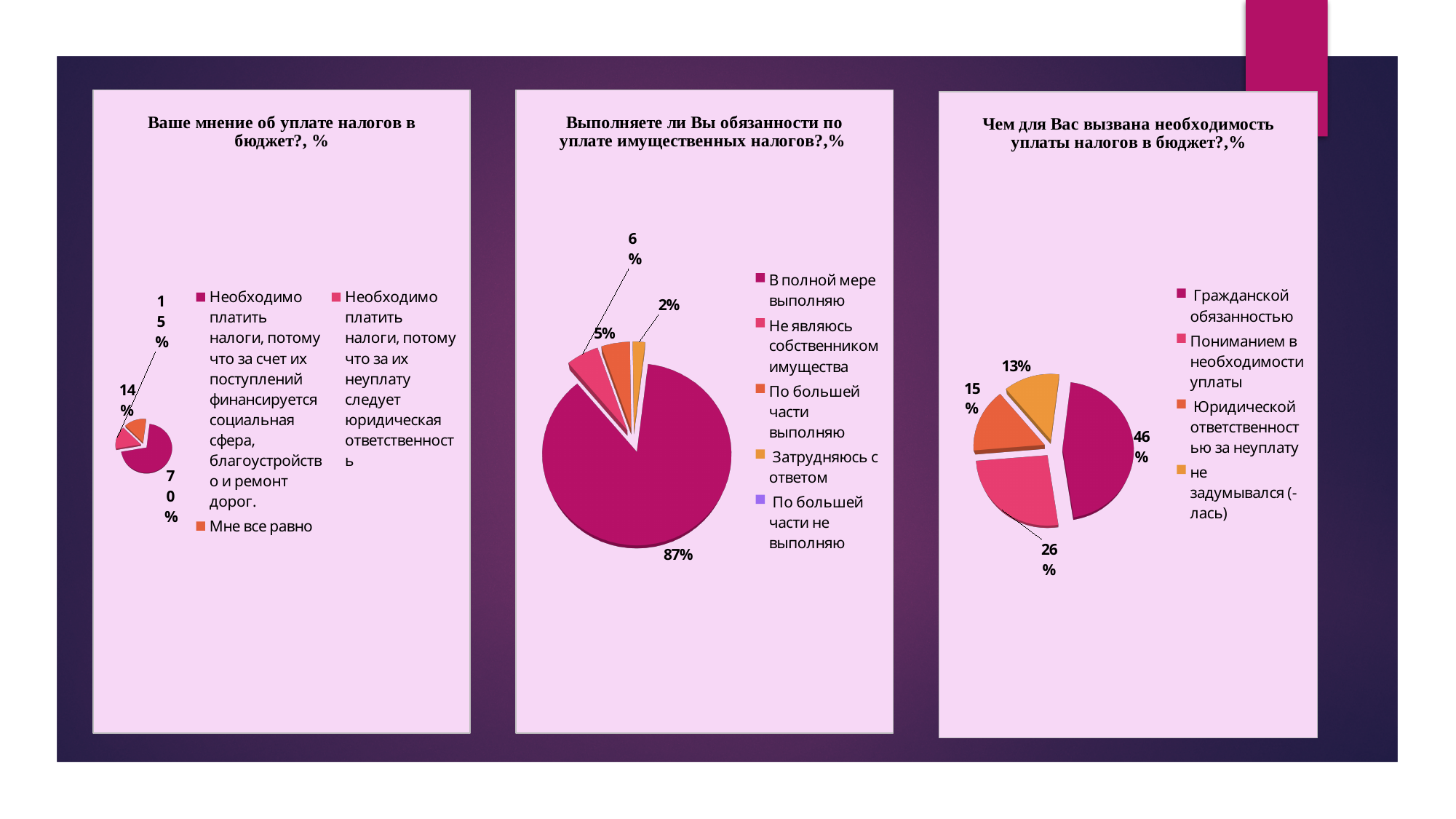
On the chart titled "Ваше мнение об уплате налогов в бюджет?, %", which category has the largest slice? Необходимо платить налоги, потому что за счет их поступлений финансируется социальная сфера, благоустройство и ремонт дорог. On the chart titled "Выполняете ли Вы обязанности по уплате имущественных налогов?,%", how many entries does the legend list? 5 On the chart titled "Чем для Вас вызвана необходимость уплаты налогов в бюджет?,%", what share is labelled for "Пониманием в необходимости уплаты"? 26% On the chart titled "Ваше мнение об уплате налогов в бюджет?, %", what share is labelled for "Мне все равно"? 14% On the chart titled "Выполняете ли Вы обязанности по уплате имущественных налогов?,%", what share is labelled for "Затрудняюсь с ответом"? 2% What type of chart is the chart titled "Ваше мнение об уплате налогов в бюджет?, %"? Pie chart On the chart titled "Чем для Вас вызвана необходимость уплаты налогов в бюджет?,%", what share is labelled for "Гражданской обязанностью"? 46% On the chart titled "Выполняете ли Вы обязанности по уплате имущественных налогов?,%", what share is labelled for "В полной мере выполняю"? 87% On the chart titled "Выполняете ли Вы обязанности по уплате имущественных налогов?,%", which is larger: "Не являюсь собственником имущества" or "По большей части выполняю"? Не являюсь собственником имущества How many charts are shown on the slide? 3 On the chart titled "Чем для Вас вызвана необходимость уплаты налогов в бюджет?,%", which category has the smallest slice? не задумывался (-лась) On the chart titled "Чем для Вас вызвана необходимость уплаты налогов в бюджет?,%", what is the difference between the "Гражданской обязанностью" slice and the "Пониманием в необходимости уплаты" slice? 20%